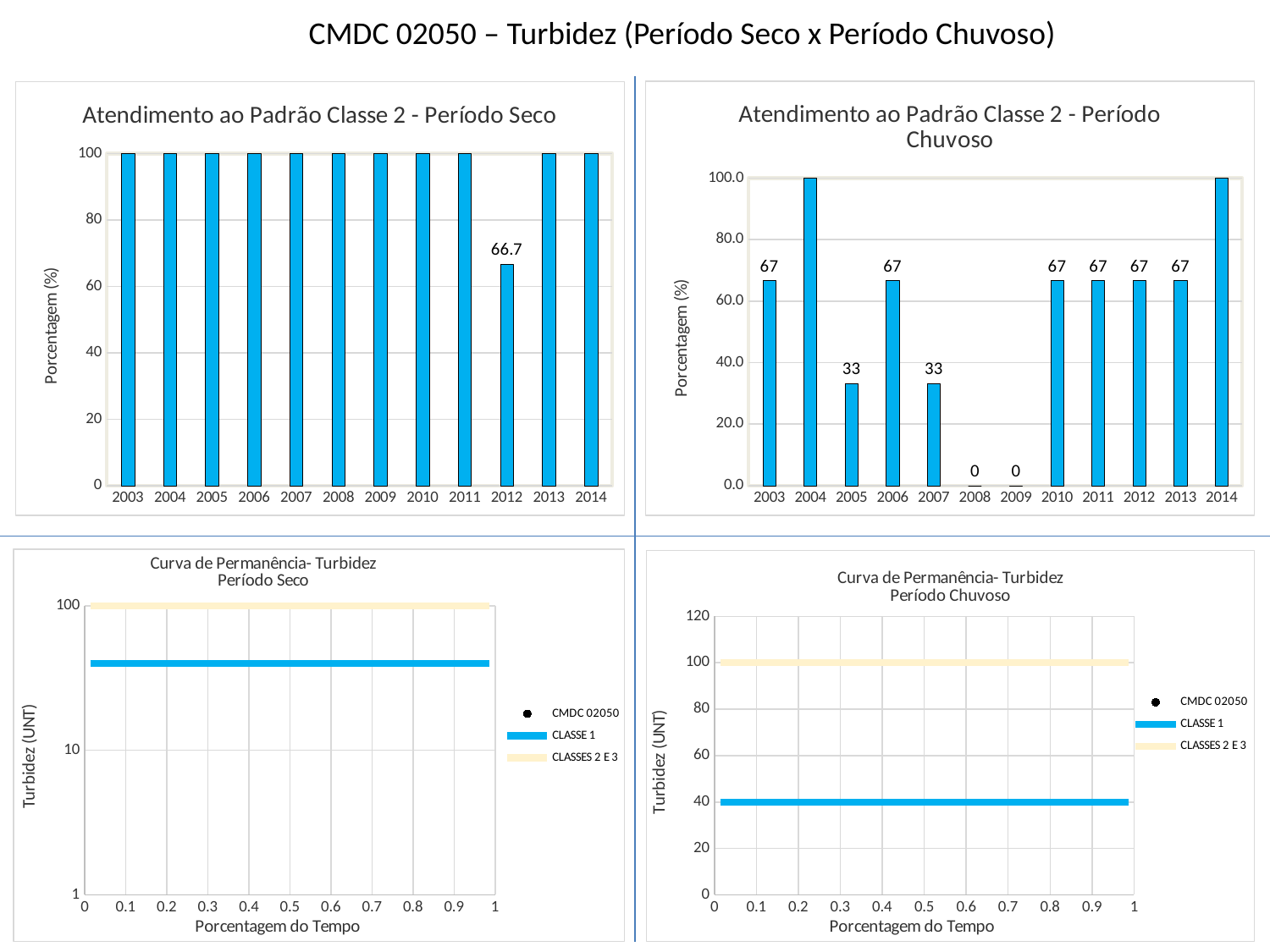
In the chart 'Atendimento ao Padrão Classe 2 - Período Chuvoso', what is the value for 2008? 0 In the chart 'Atendimento ao Padrão Classe 2 - Período Chuvoso', what is the difference between the values for 2003 and 2005? 34 In the chart 'Atendimento ao Padrão Classe 2 - Período Chuvoso', how many years have a value of 67? 6 In the chart 'Atendimento ao Padrão Classe 2 - Período Chuvoso', which year has the larger value, 2004 or 2007? 2004 In the chart 'Curva de Permanência- Turbidez Período Chuvoso', what are the legend entries? CMDC 02050, CLASSE 1, CLASSES 2 E 3 In the chart 'Atendimento ao Padrão Classe 2 - Período Seco', how many years are shown on the x axis? 12 In the chart 'Atendimento ao Padrão Classe 2 - Período Chuvoso', is the value for 2004 greater or less than 80.0? greater In the chart 'Atendimento ao Padrão Classe 2 - Período Seco', what is the value for 2012? 66.7 How many series does the legend of the chart 'Curva de Permanência- Turbidez Período Seco' list? 3 In the chart 'Atendimento ao Padrão Classe 2 - Período Chuvoso', what is the value for 2005? 33 In the chart 'Atendimento ao Padrão Classe 2 - Período Seco', which year has the lowest value? 2012 What kind of chart is 'Atendimento ao Padrão Classe 2 - Período Seco'? bar chart